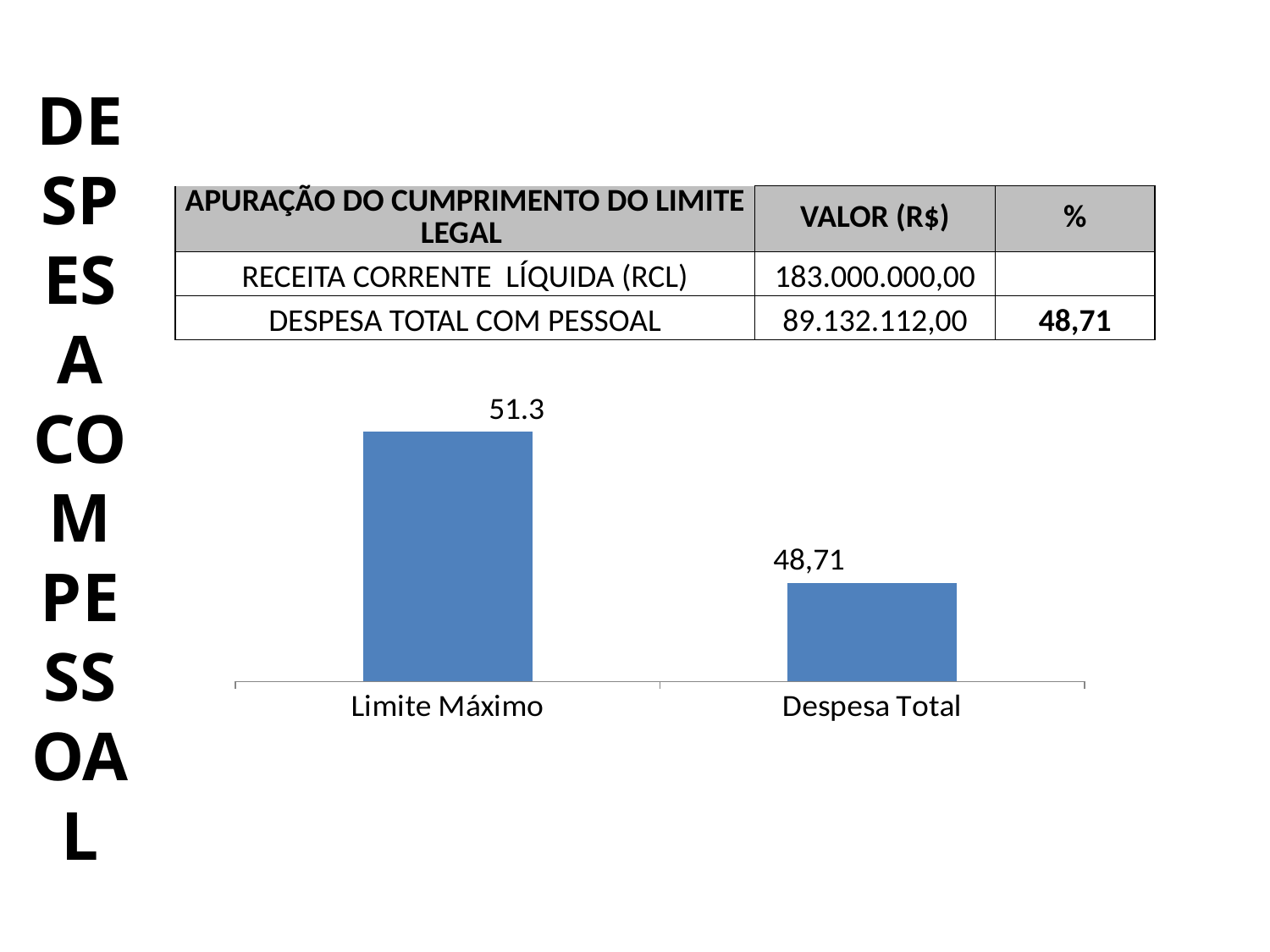
What is the value shown for Limite Máximo? 51.3 Do the values rise or fall from left to right along the x axis? Fall Which category has the highest bar? Limite Máximo Which is larger, the value for Limite Máximo or the value for Despesa Total? Limite Máximo Which category has the lowest bar? Despesa Total What colour are the bars in the chart? Blue How many bars are plotted in the chart? 2 What are the two category labels on the x axis of the chart? Limite Máximo and Despesa Total What kind of chart is shown on the slide? Bar chart What is the value shown for Despesa Total? 48,71